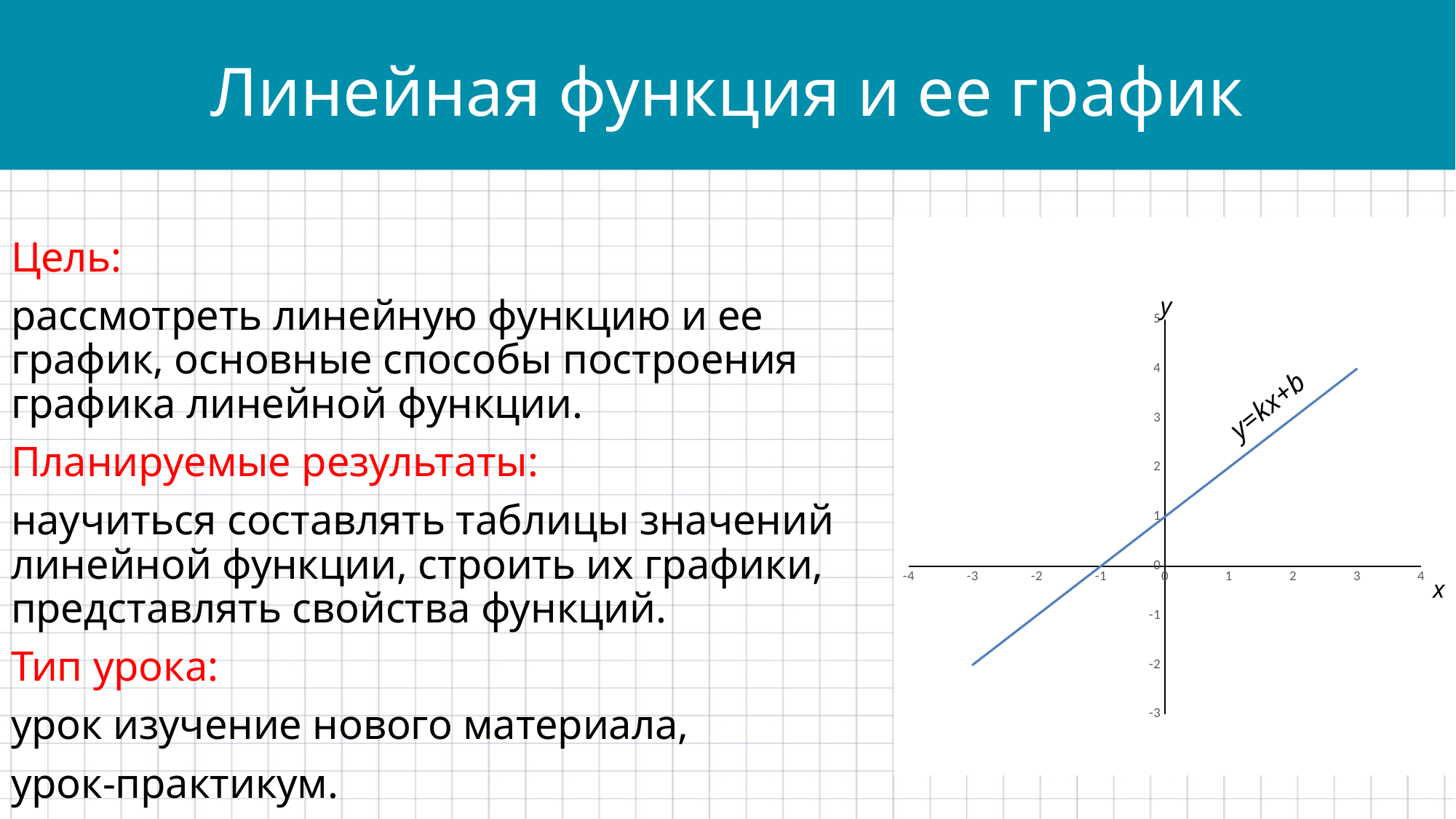
How many lines are plotted on the chart? 1 Does the plotted line rise or fall as x increases? rises What kind of chart is shown on the right of the slide? line chart At what y value does the line cross the y axis? 1 What colour is the plotted line? blue Is the value of the line at x = -3 greater or less than 0? less What is the largest value shown on the x axis? 4 What is the smallest value shown on the y axis? -3 What equation labels the plotted line? y=kx+b Is the value of the line at x = 3 greater or less than 3? greater Is the value of the line at x = 1 greater or less than 1? greater At what x value does the line cross the x axis? -1